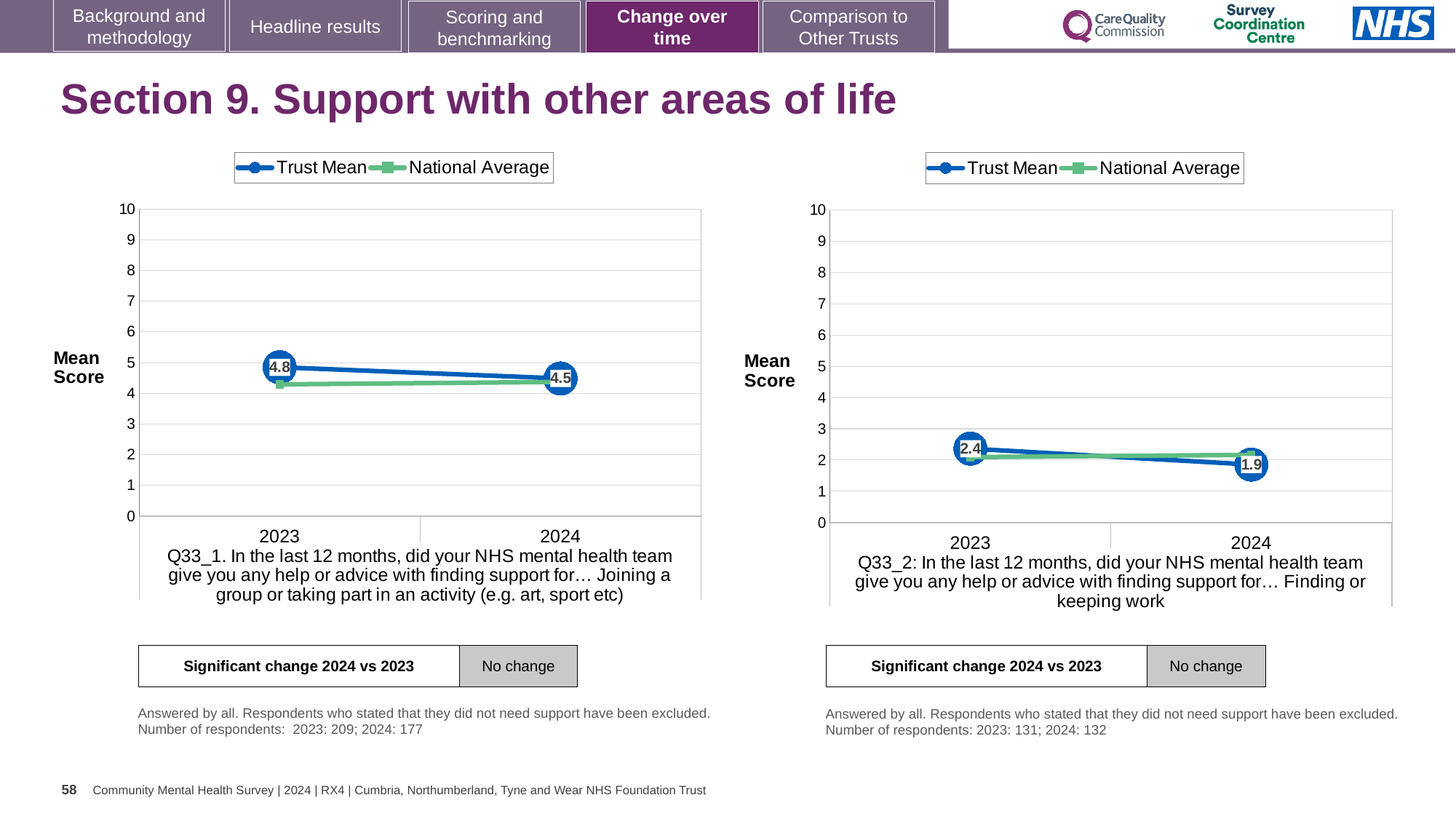
In the right chart (Q33_2), is the National Average for 2024 greater or less than 3? less In the right chart (Q33_2), what is the Trust Mean for 2023? 2.4 In the left chart (Q33_1), what is the Trust Mean for 2024? 4.5 In the left chart (Q33_1), which year has the higher Trust Mean, 2023 or 2024? 2023 In the right chart (Q33_2), what is the difference between the Trust Mean in 2023 and in 2024? 0.5 In the left chart (Q33_1), is the National Average for 2023 greater or less than 5? less What type of chart is the right chart (Q33_2)? line chart In the left chart (Q33_1), what is the Trust Mean for 2023? 4.8 In the right chart (Q33_2), does the Trust Mean rise or fall from 2023 to 2024? fall In the right chart (Q33_2), what is the Trust Mean for 2024? 1.9 How many series does the legend of the left chart (Q33_1) list? 2 In the left chart (Q33_1), by how much did the Trust Mean change from 2023 to 2024? 0.3